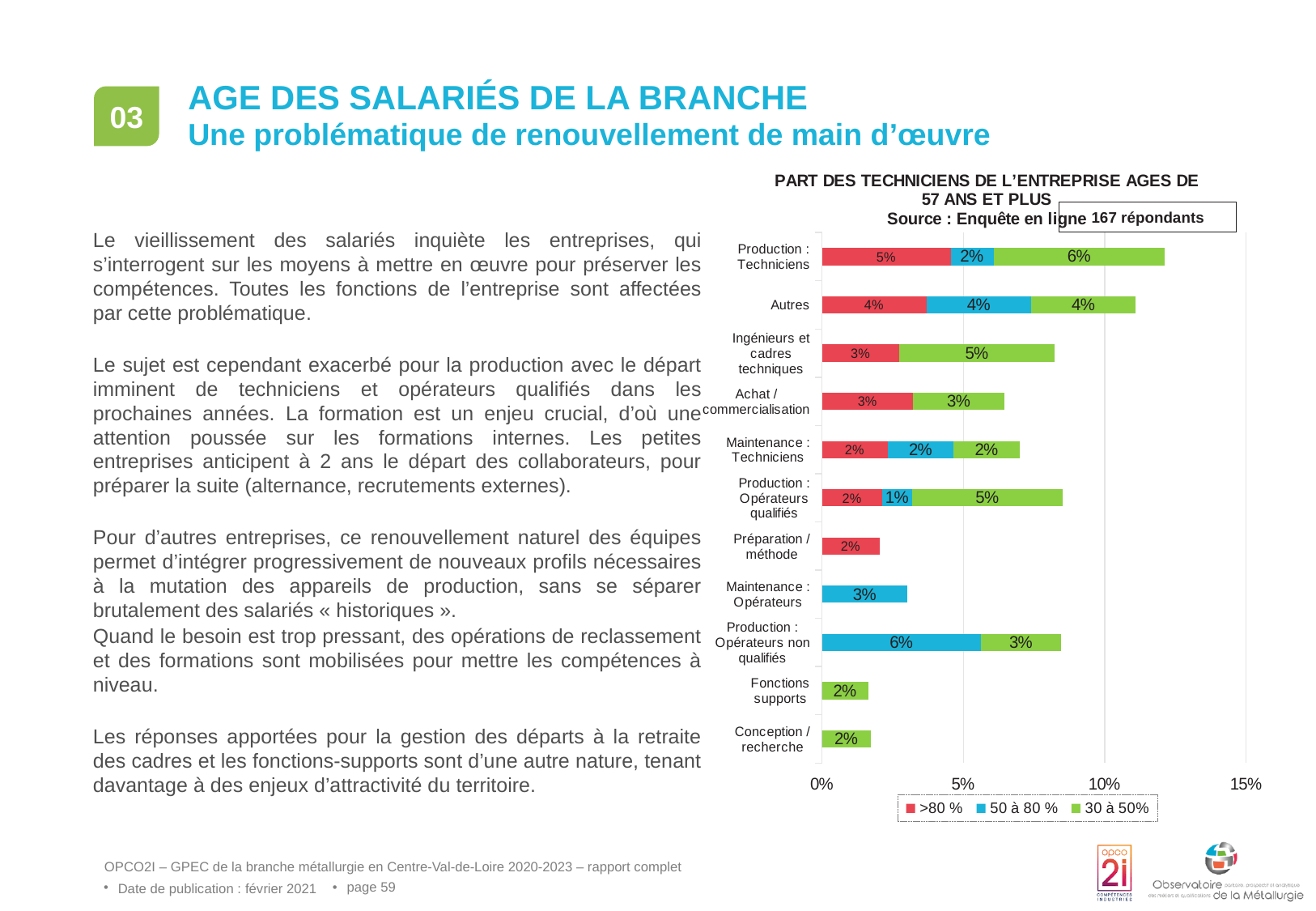
Which series is shown in green in the legend? 30 à 50% What is the difference between the '30 à 50%' value for 'Production : Techniciens' and the '30 à 50%' value for 'Autres'? 2% How many categories are plotted on the chart? 11 What is the value of the '50 à 80 %' series for 'Production : Opérateurs qualifiés'? 1% What is the value of the '30 à 50%' series for 'Ingénieurs et cadres techniques'? 5% What kind of chart is shown on the slide? Stacked bar chart How many series does the chart legend list? 3 What is the value of the '50 à 80 %' series for 'Production : Opérateurs non qualifiés'? 6% Which category has the longest overall bar? Production : Techniciens What is the value of the '>80 %' series for 'Production : Techniciens'? 5% Which is larger: the '50 à 80 %' value for 'Autres' or the '50 à 80 %' value for 'Maintenance : Techniciens'? Autres Which category has the highest value in the '>80 %' series? Production : Techniciens